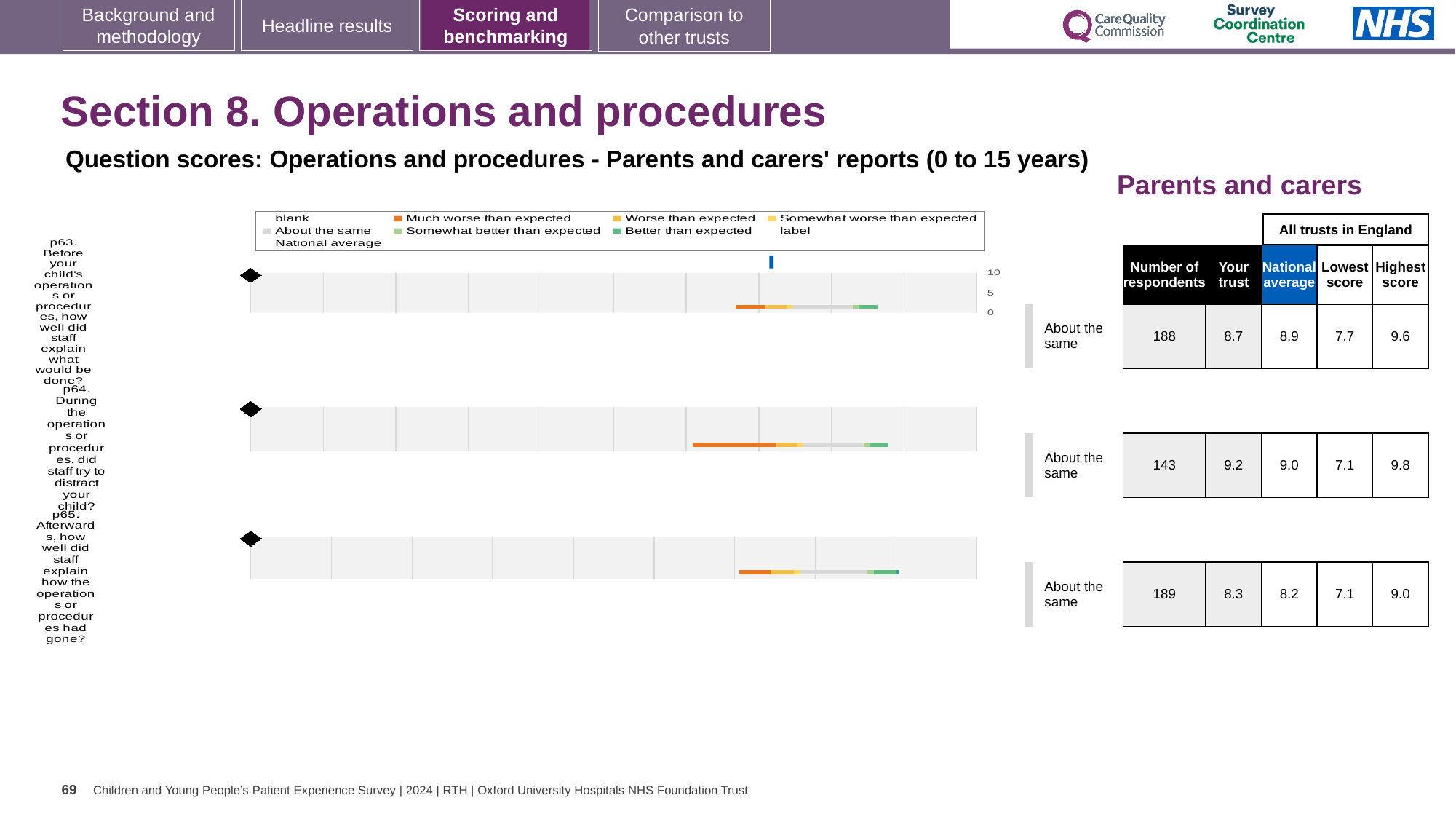
What colour does the legend use for 'Much worse than expected'? orange Which question has the lowest 'National average' score? p65 How many questions (p63, p64, p65) are plotted as separate chart rows on the slide? 3 For p65 (Afterwards, how well did staff explain how the operations or procedures had gone?), what is the difference between the highest score and the lowest score? 1.9 What benchmark category is shown for p63? About the same For p64 (During the operations or procedures, did staff try to distract your child?), what is the number of respondents? 143 How many entries does the chart legend list? 9 What is the subtitle above the charts describing the question scores? Question scores: Operations and procedures - Parents and carers' reports (0 to 15 years) Which question has the highest 'Your trust' score? p64 For p63 (Before your child's operations or procedures, how well did staff explain what would be done?), what is the 'Your trust' score? 8.7 What kind of chart is used to show the question scores on this slide? bar chart For p64, which is larger: the 'Your trust' score or the 'National average'? Your trust